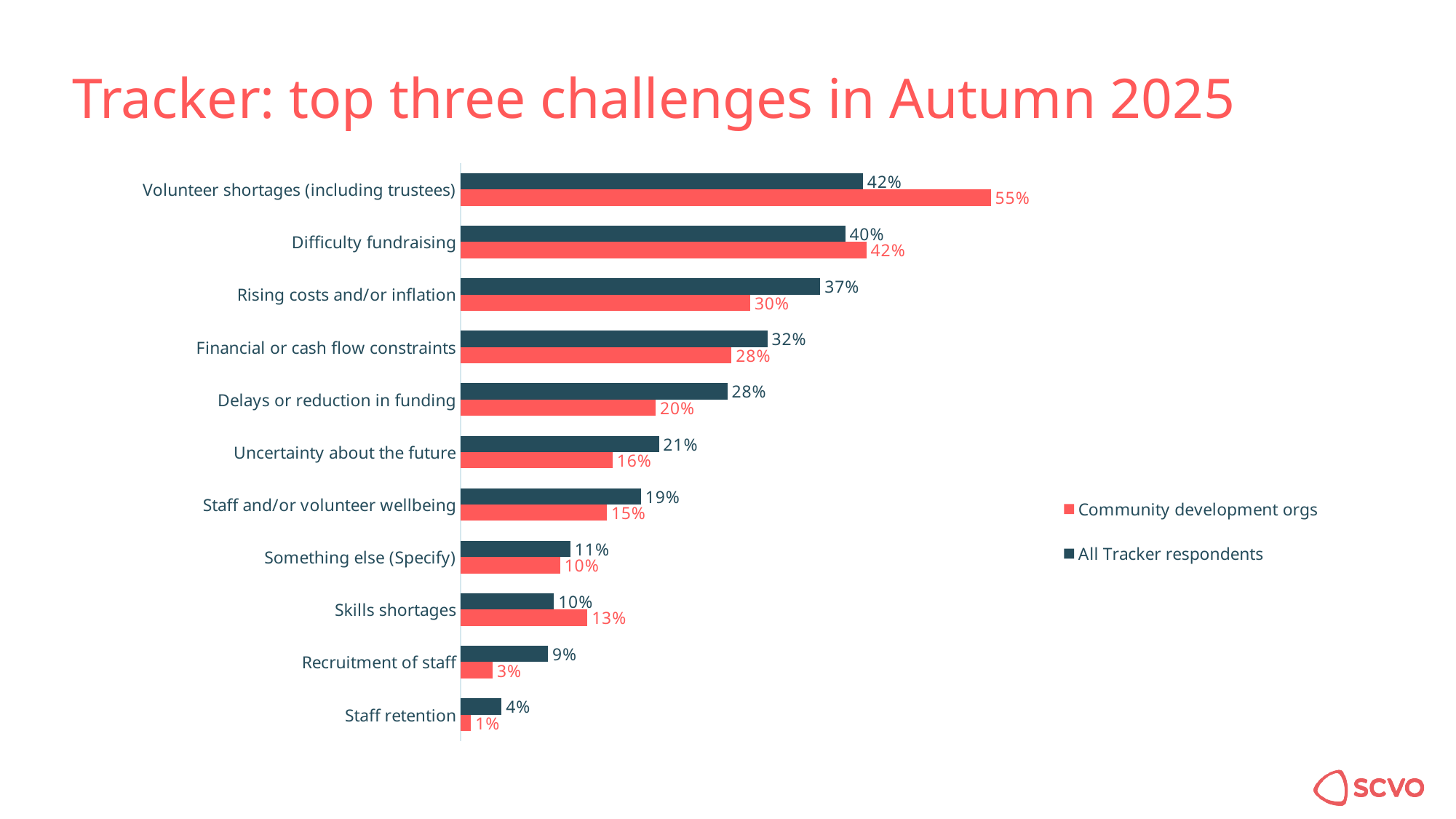
How many series does the legend list? 2 How many challenge categories are shown on the chart? 11 What type of chart is shown on the slide? Bar chart What is the difference between All Tracker respondents and Community development orgs for Recruitment of staff? 6% For Uncertainty about the future, which series has the larger value: Community development orgs or All Tracker respondents? All Tracker respondents For Skills shortages, which series has the larger value: Community development orgs or All Tracker respondents? Community development orgs Which challenge has the highest value for Community development orgs? Volunteer shortages (including trustees) What is the value for All Tracker respondents for Rising costs and/or inflation? 37% What is the difference between Community development orgs and All Tracker respondents for Volunteer shortages (including trustees)? 13% What percentage of Community development orgs reported Volunteer shortages (including trustees) as a challenge? 55% What is the value for Community development orgs for Delays or reduction in funding? 20% Which challenge has the lowest value for All Tracker respondents? Staff retention